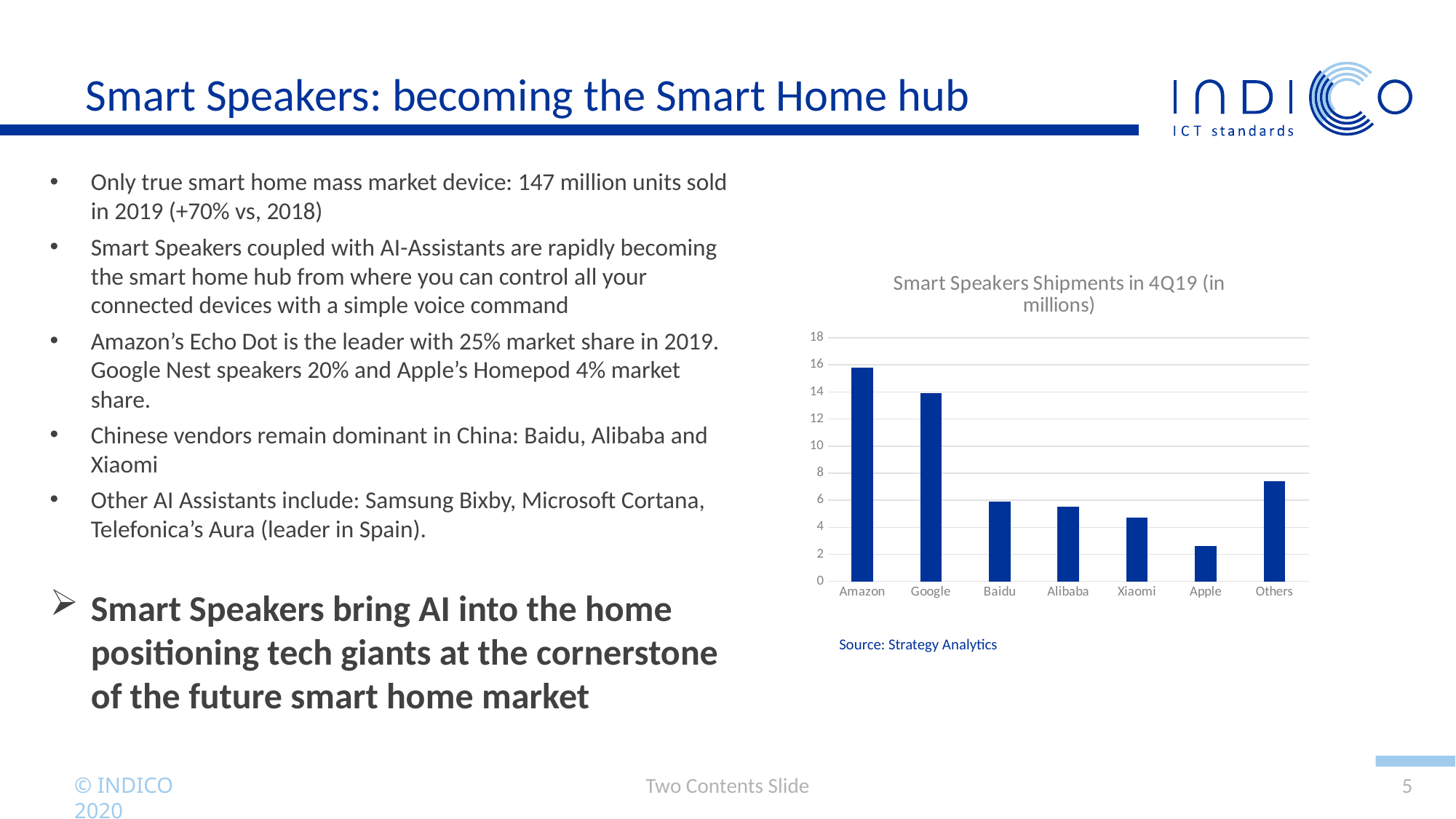
Which vendor has the lowest shipments in the chart? Apple Is the value for Others greater or less than 6? greater Which is larger, the value for Others or the value for Baidu? Others Is the value for Xiaomi greater or less than 6? less Which is larger, the value for Google or the value for Amazon? Amazon Is the value for Google greater or less than 12? greater What is the title of the chart? Smart Speakers Shipments in 4Q19 (in millions) What type of chart is shown on the slide? bar chart How many vendor categories are shown on the x axis of the chart? 7 Which vendor has the highest shipments in the chart? Amazon